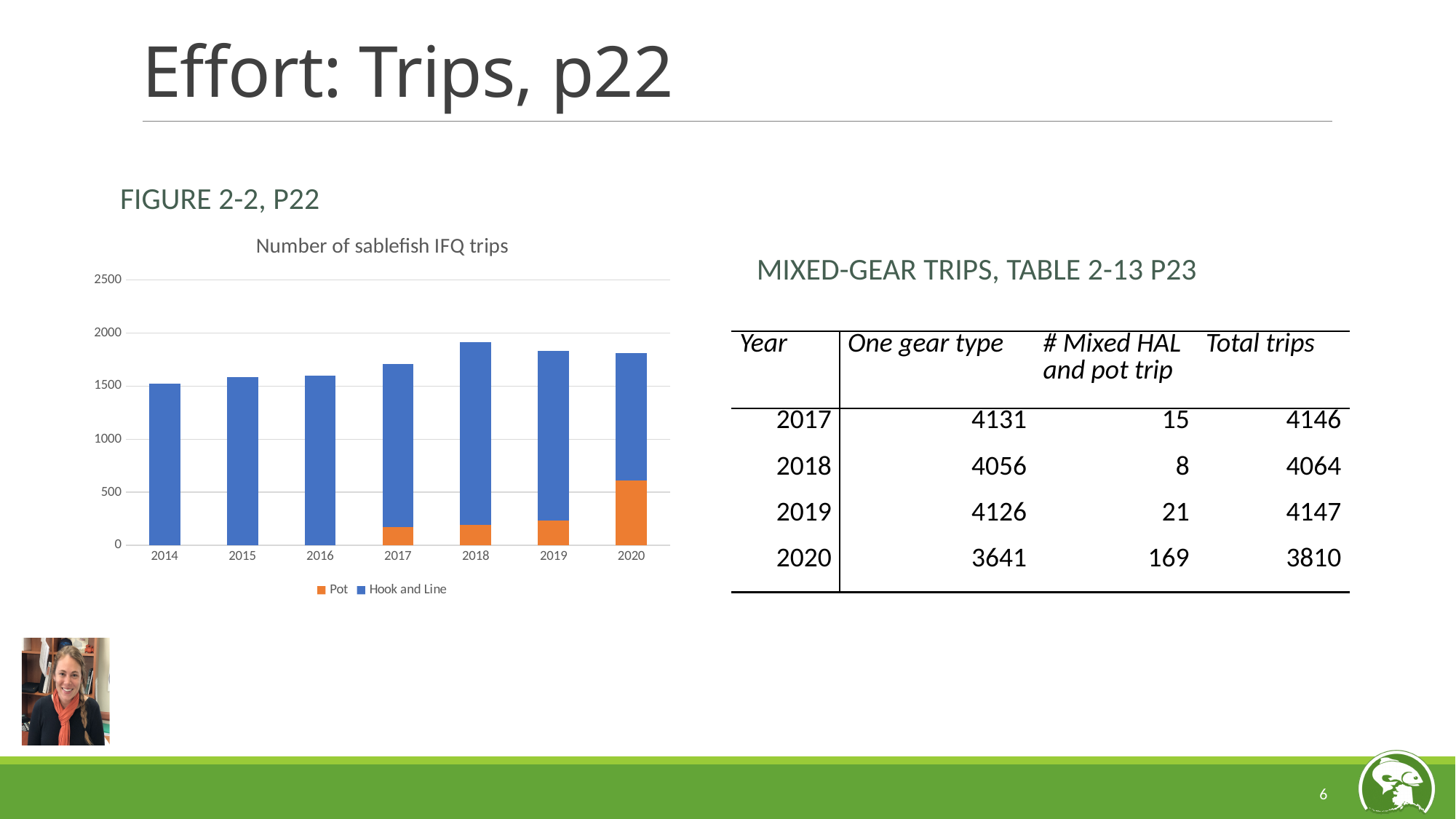
Which year has more Pot trips, 2017 or 2020? 2020 Which year has the lowest total number of sablefish IFQ trips? 2014 How many years are shown on the x axis of the chart? 7 Do the Pot trips rise or fall from 2017 to 2020? rise Is the number of Pot trips in 2017 greater or less than 500? less How many series does the chart legend list? 2 Is the total number of trips in 2019 greater or less than 1500? greater What kind of chart is shown on the slide? bar chart Is the number of Pot trips in 2020 greater or less than 500? greater Which year has the highest total number of sablefish IFQ trips? 2018 What is the title of the chart? Number of sablefish IFQ trips